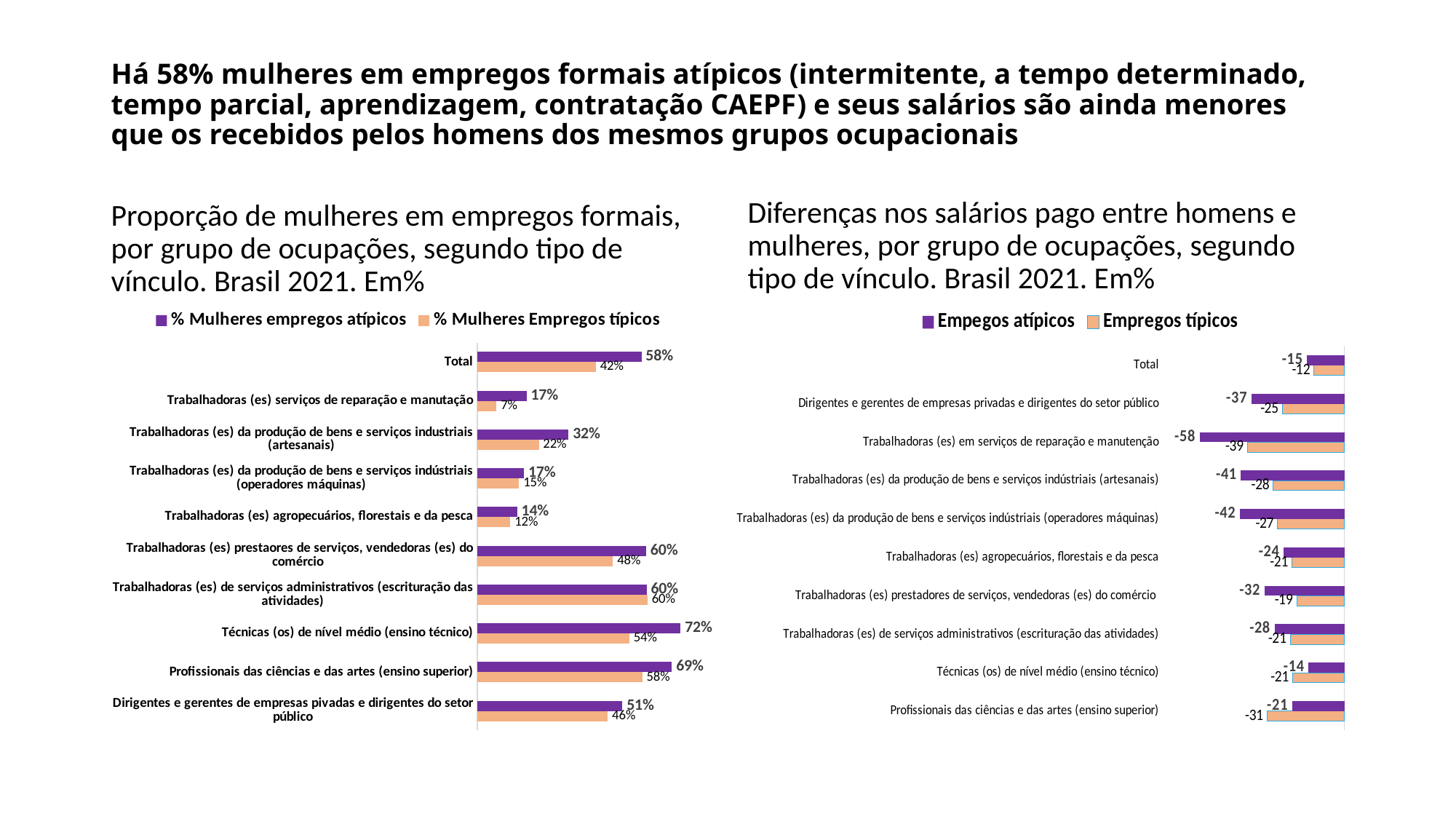
In the right chart (Diferenças nos salários), what is the value of Empregos típicos for Profissionais das ciências e das artes (ensino superior)? -31 In the left chart (Proporção de mulheres em empregos formais), how many series does the legend list? 2 What kind of chart is the right chart (Diferenças nos salários)? Bar chart In the right chart (Diferenças nos salários), what is the difference between the Empegos atípicos and Empregos típicos values for Total? 3 In the left chart (Proporção de mulheres em empregos formais), how many categories are shown? 10 In the left chart (Proporção de mulheres em empregos formais), which category has the highest value for % Mulheres empregos atípicos? Técnicas (os) de nível médio (ensino técnico) In the left chart (Proporção de mulheres em empregos formais), what is the difference between the atípicos and típicos values for Técnicas (os) de nível médio (ensino técnico)? 18% In the right chart (Diferenças nos salários), which category has the lowest (most negative) value for Empegos atípicos? Trabalhadoras (es) em serviços de reparação e manutenção In the right chart (Diferenças nos salários), what is the value of Empegos atípicos for Trabalhadoras (es) em serviços de reparação e manutenção? -58 In the right chart (Diferenças nos salários), which is larger for Técnicas (os) de nível médio (ensino técnico): the Empegos atípicos value or the Empregos típicos value? Empegos atípicos In the left chart (Proporção de mulheres em empregos formais), what is the value of % Mulheres empregos atípicos for Total? 58% In the left chart (Proporção de mulheres em empregos formais), what is the value of % Mulheres Empregos típicos for Trabalhadoras (es) serviços de reparação e manutação? 7%